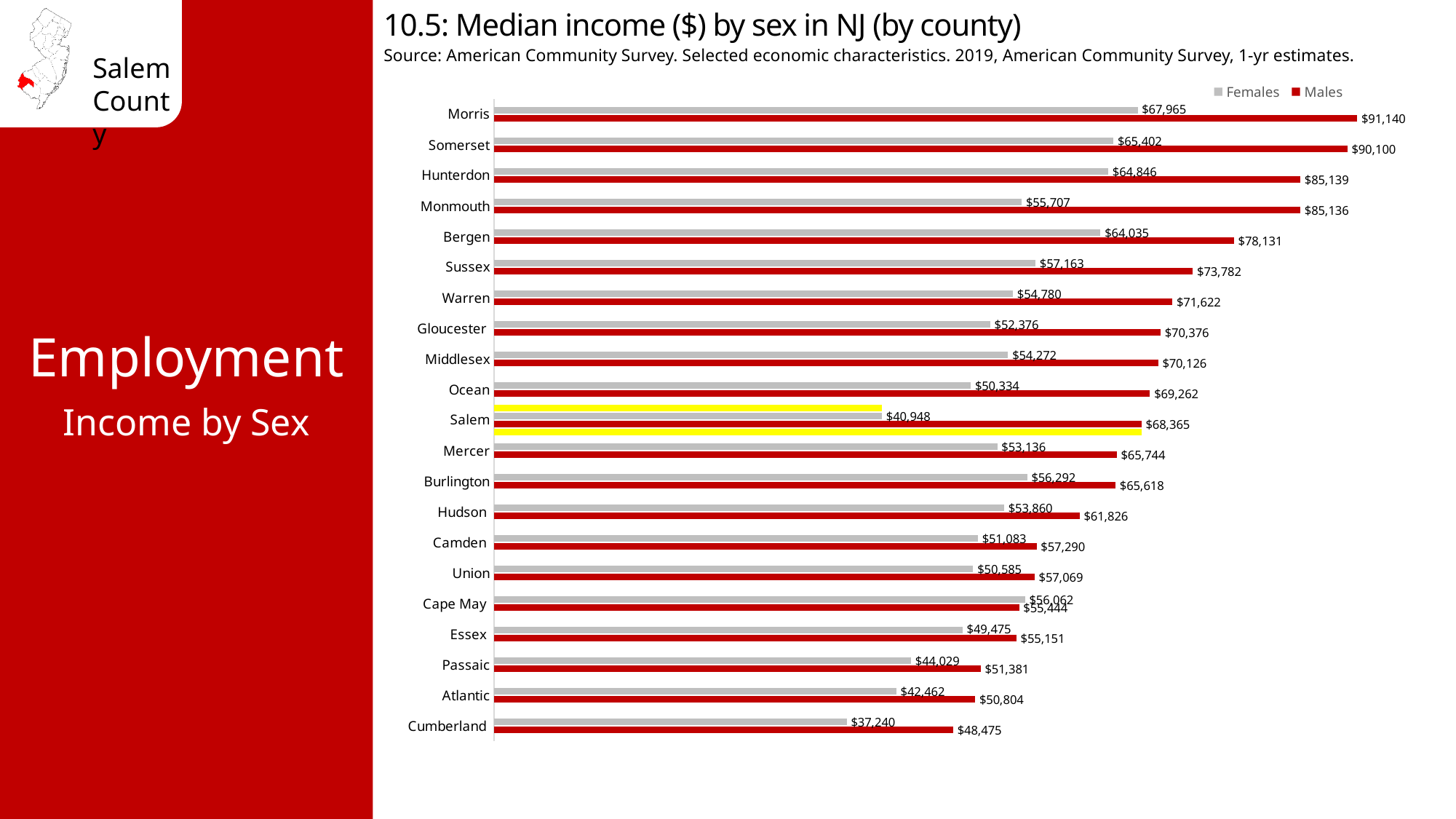
How many series does the legend list? 2 What is the difference between the Males and Females median income in Morris County? $23,175 What is the median income for Females in Salem County? $40,948 In Cape May County, which is larger, the median income for Females or for Males? Females What is the median income for Males in Cumberland County? $48,475 What kind of chart is shown on the slide? Bar chart What is the median income for Females in Morris County? $67,965 Which county has the highest median income for Males? Morris What is the difference between the Males and Females median income in Salem County? $27,417 Which county has the lowest median income for Females? Cumberland How many counties are shown in the chart? 21 What is the median income for Males in Salem County? $68,365